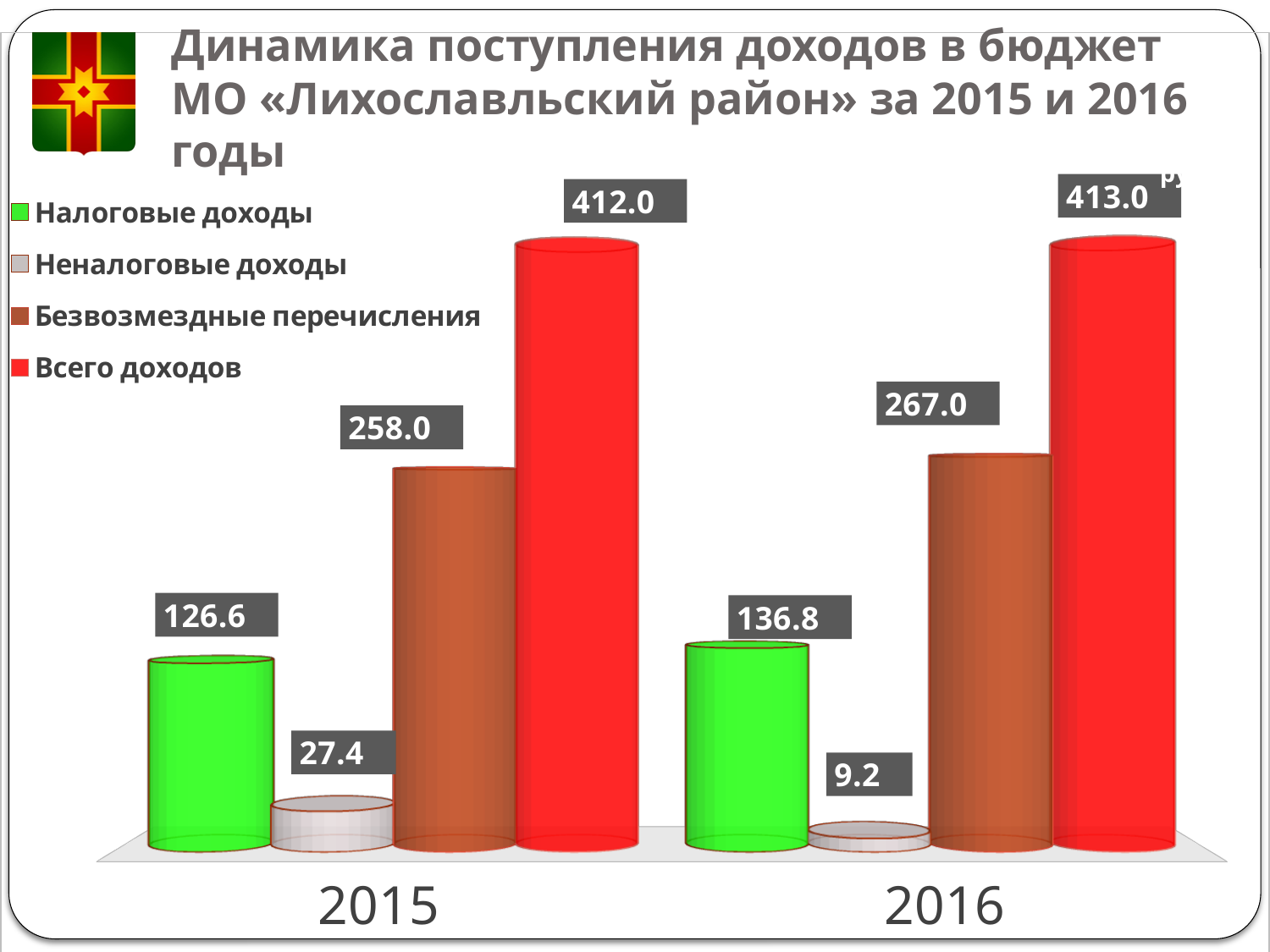
Which series has the highest value in 2015? Всего доходов What is the value of Налоговые доходы for 2015? 126.6 Which series has the lowest value in 2016? Неналоговые доходы What is the value of Безвозмездные перечисления for 2016? 267.0 What is the difference between Налоговые доходы in 2016 and in 2015? 10.2 How many series does the legend list? 4 What is the difference between Неналоговые доходы in 2015 and in 2016? 18.2 What is the value of Неналоговые доходы for 2016? 9.2 Which is larger: Безвозмездные перечисления in 2015 or in 2016? 2016 What kind of chart is shown on the slide? Bar chart How many years are shown on the x axis? 2 What is the value of Всего доходов for 2015? 412.0